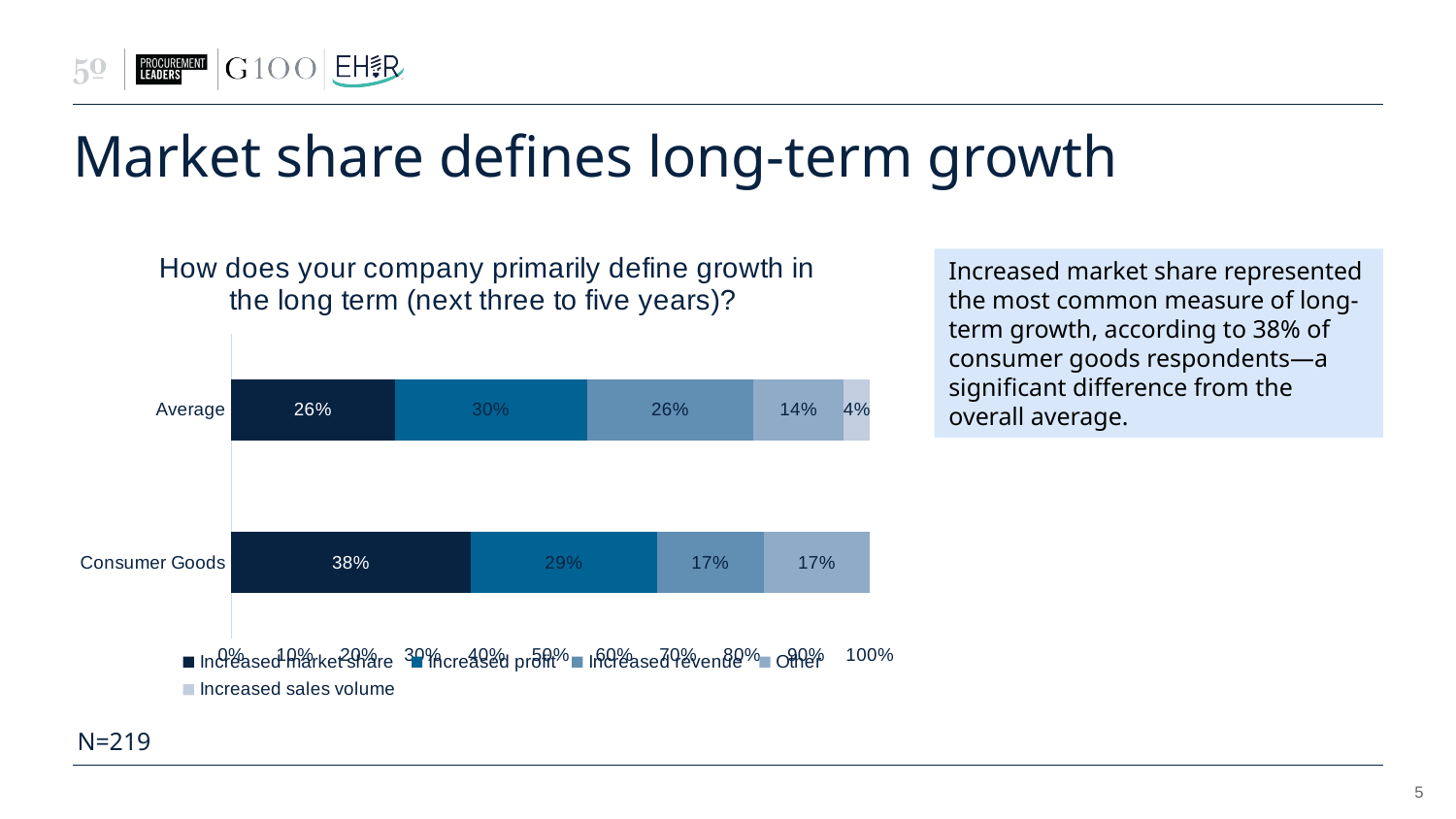
What is the Average value for increased profit? 30% What is the Consumer Goods value for increased revenue? 17% What is the Average value for increased sales volume? 4% What kind of chart is shown on the slide? Stacked bar chart Which is larger: the Average value for increased revenue or the Consumer Goods value for increased revenue? Average How many percentage points higher is the Consumer Goods value for increased market share than the Average value? 12 What is the Average value for Other? 14% Which segment is the largest in the Average bar? Increased profit What percentage of Consumer Goods respondents define long-term growth as increased market share? 38% How many categories (bars) does the chart show? 2 What is the sample size (N) stated on the slide? N=219 How many series does the legend list? 5